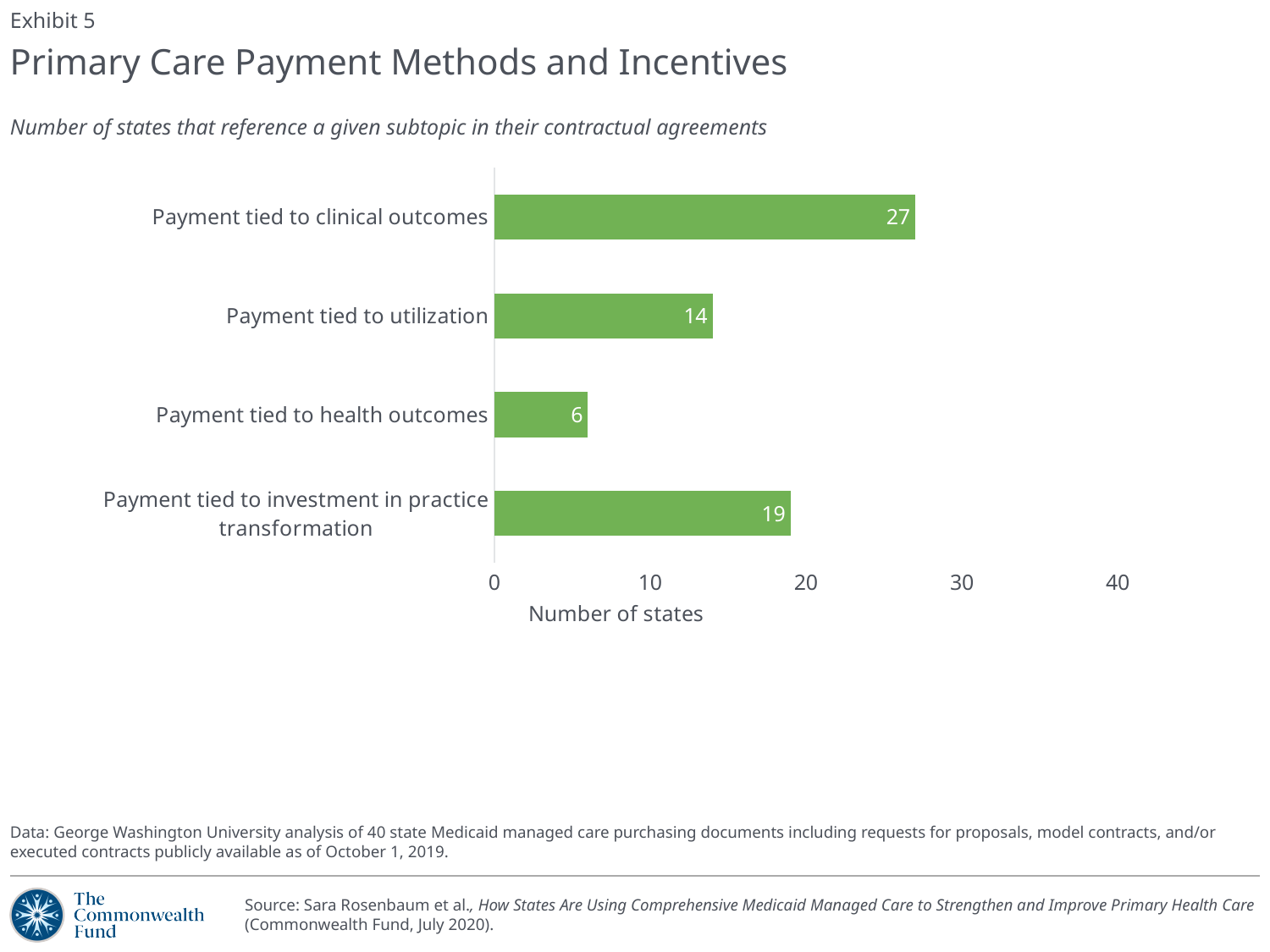
Is the value for payment tied to clinical outcomes greater or less than 20? greater What is the number of states for payment tied to utilization? 14 Which has more states: payment tied to utilization or payment tied to investment in practice transformation? Payment tied to investment in practice transformation What is the label of the horizontal axis? Number of states Which subtopic is referenced by the most states? Payment tied to clinical outcomes What is the difference between the number of states for payment tied to clinical outcomes and payment tied to utilization? 13 What type of chart is shown on the slide? Bar chart What is the value for payment tied to health outcomes? 6 How many states reference payment tied to clinical outcomes? 27 Which subtopic is referenced by the fewest states? Payment tied to health outcomes How many subtopics are shown in the chart? 4 How many states reference payment tied to investment in practice transformation? 19